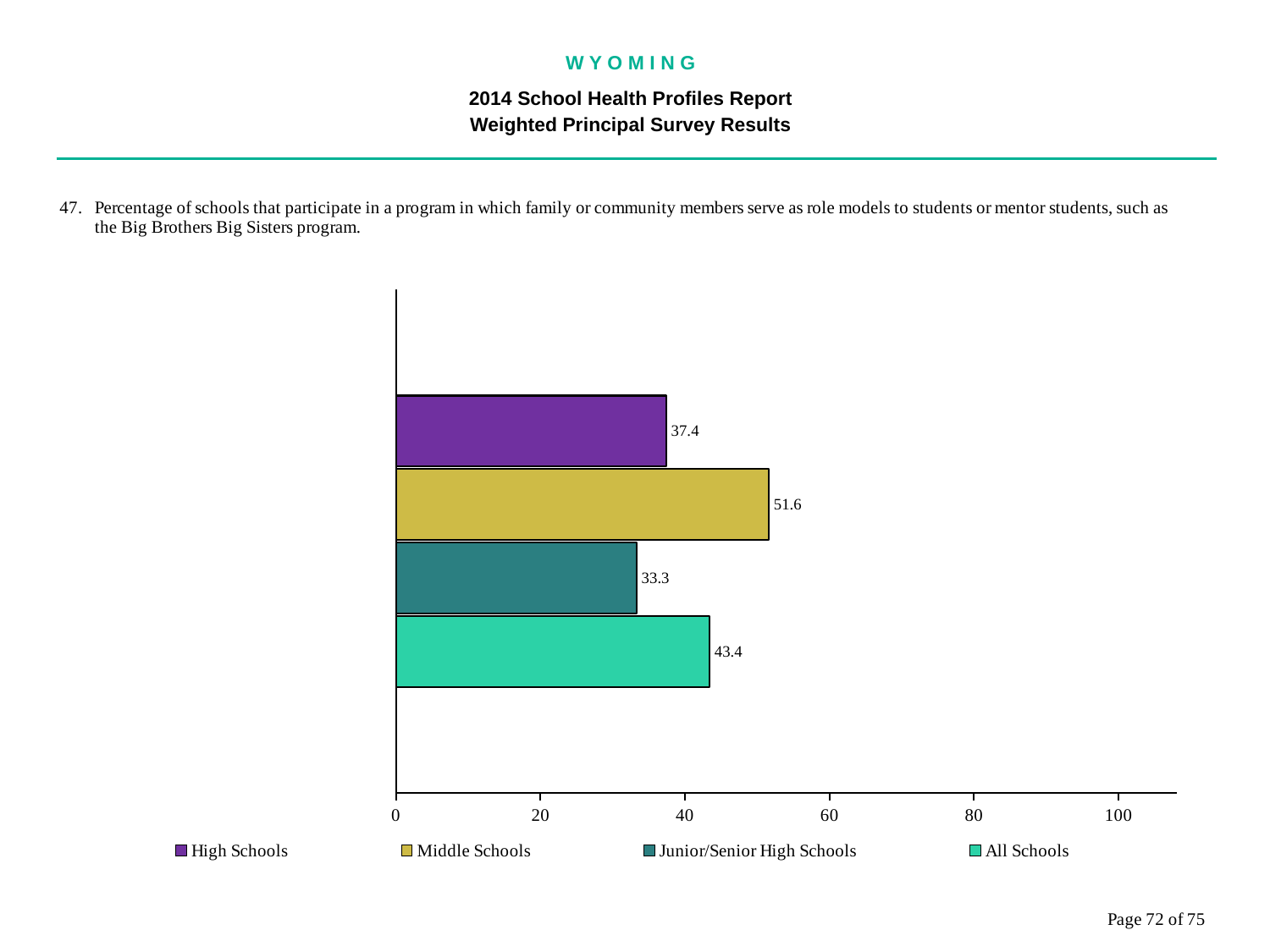
Is the value for Middle Schools greater or less than 40? greater What is the value for Junior/Senior High Schools? 33.3 Which school type has the lowest value? Junior/Senior High Schools What is the difference between the values for All Schools and Junior/Senior High Schools? 10.1 What is the value for All Schools? 43.4 What is the value for High Schools? 37.4 What is the value for Middle Schools? 51.6 What is the difference between the values for Middle Schools and High Schools? 14.2 What kind of chart is shown on the slide? bar chart Which is larger, the value for High Schools or the value for All Schools? All Schools Which school type has the highest value? Middle Schools How many series does the legend list? 4